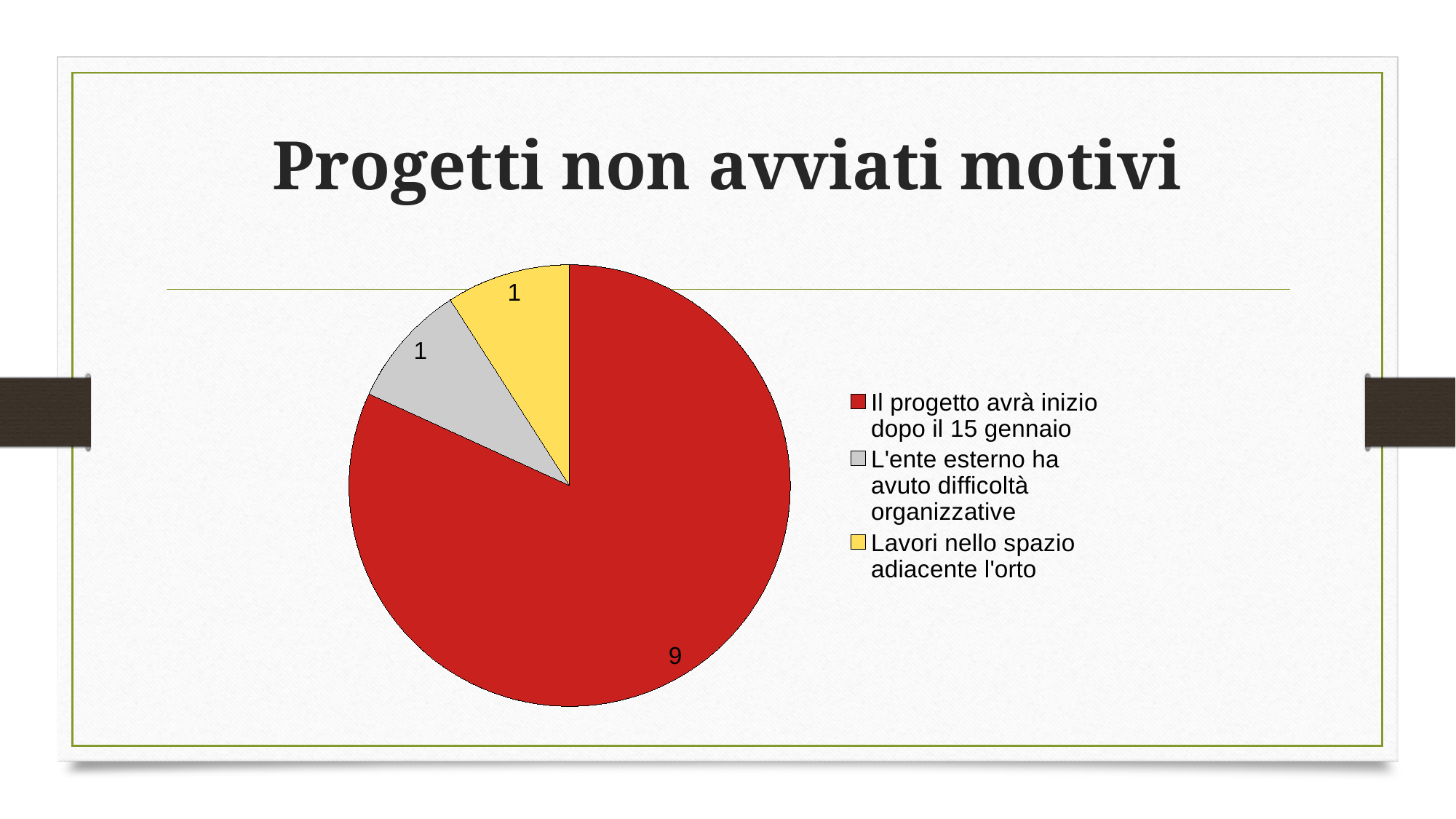
Which is larger: the value for "Il progetto avrà inizio dopo il 15 gennaio" or the value for "L'ente esterno ha avuto difficoltà organizzative"? Il progetto avrà inizio dopo il 15 gennaio What is the value for "Lavori nello spazio adiacente l'orto"? 1 What is the value for "Il progetto avrà inizio dopo il 15 gennaio"? 9 What colour is the slice for "Lavori nello spazio adiacente l'orto"? yellow What is the title of the slide containing the chart? Progetti non avviati motivi How many entries does the legend list? 3 What is the value for "L'ente esterno ha avuto difficoltà organizzative"? 1 Which category has the largest slice of the pie? Il progetto avrà inizio dopo il 15 gennaio How many slices does the pie chart have? 3 What kind of chart is shown on the slide? pie chart What is the difference between the value for "Il progetto avrà inizio dopo il 15 gennaio" and the value for "Lavori nello spazio adiacente l'orto"? 8 What is the total of all the slices in the pie chart? 11